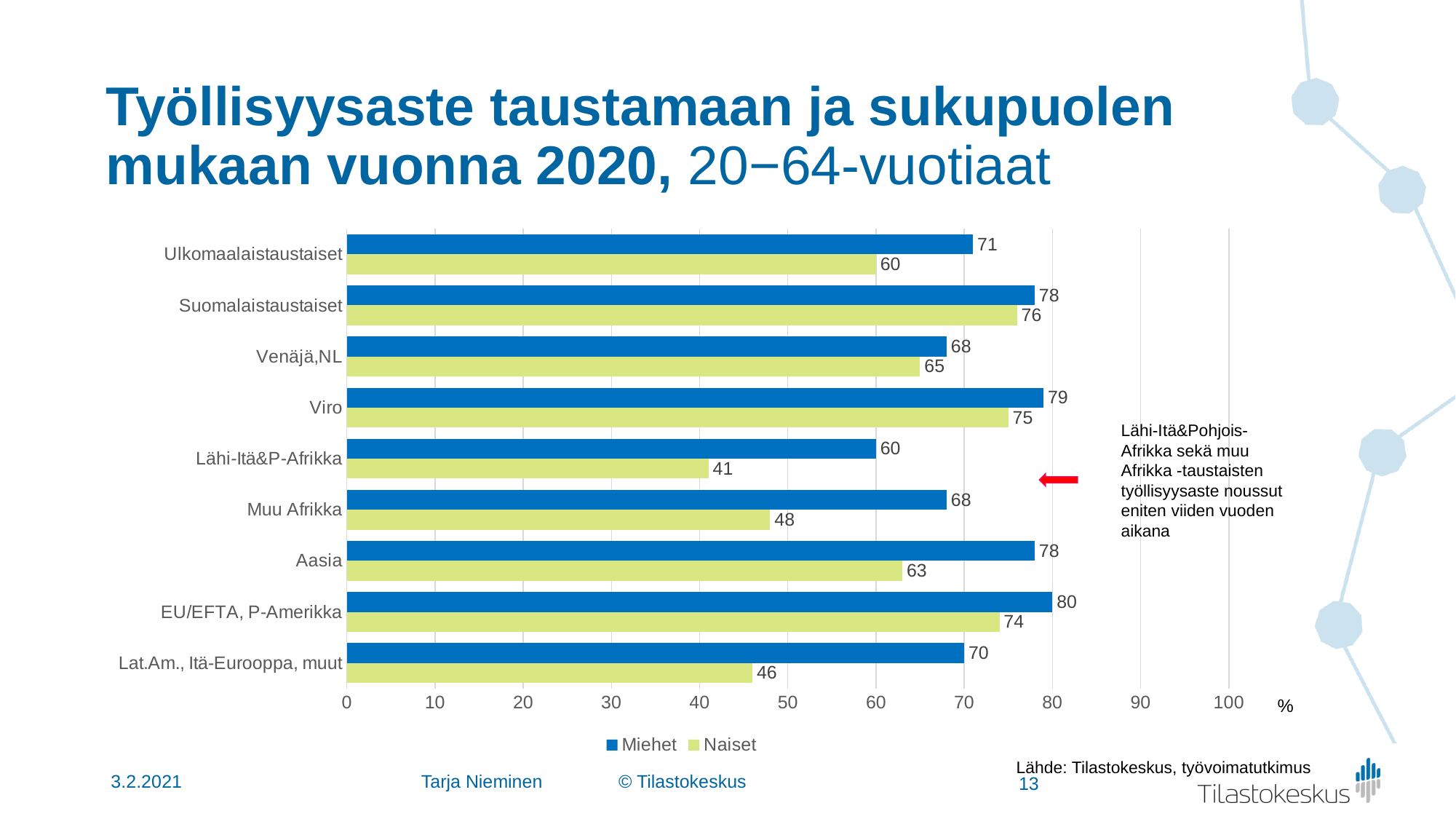
What is the difference between the Miehet and Naiset values for Muu Afrikka? 20 Which category has the lowest Naiset value? Lähi-Itä&P-Afrikka What is the Miehet value for Viro? 79 Which category has the highest Miehet value? EU/EFTA, P-Amerikka What kind of chart is shown on the slide? bar chart How many series does the legend list? 2 Which series is shown in green in the legend? Naiset What is the difference between the Miehet values for Ulkomaalaistaustaiset and Suomalaistaustaiset? 7 What is the Naiset value for Lähi-Itä&P-Afrikka? 41 Which is larger, the Naiset value for Aasia or the Naiset value for Venäjä,NL? Venäjä,NL How many categories are shown on the y axis? 9 What is the Naiset value for Suomalaistaustaiset? 76